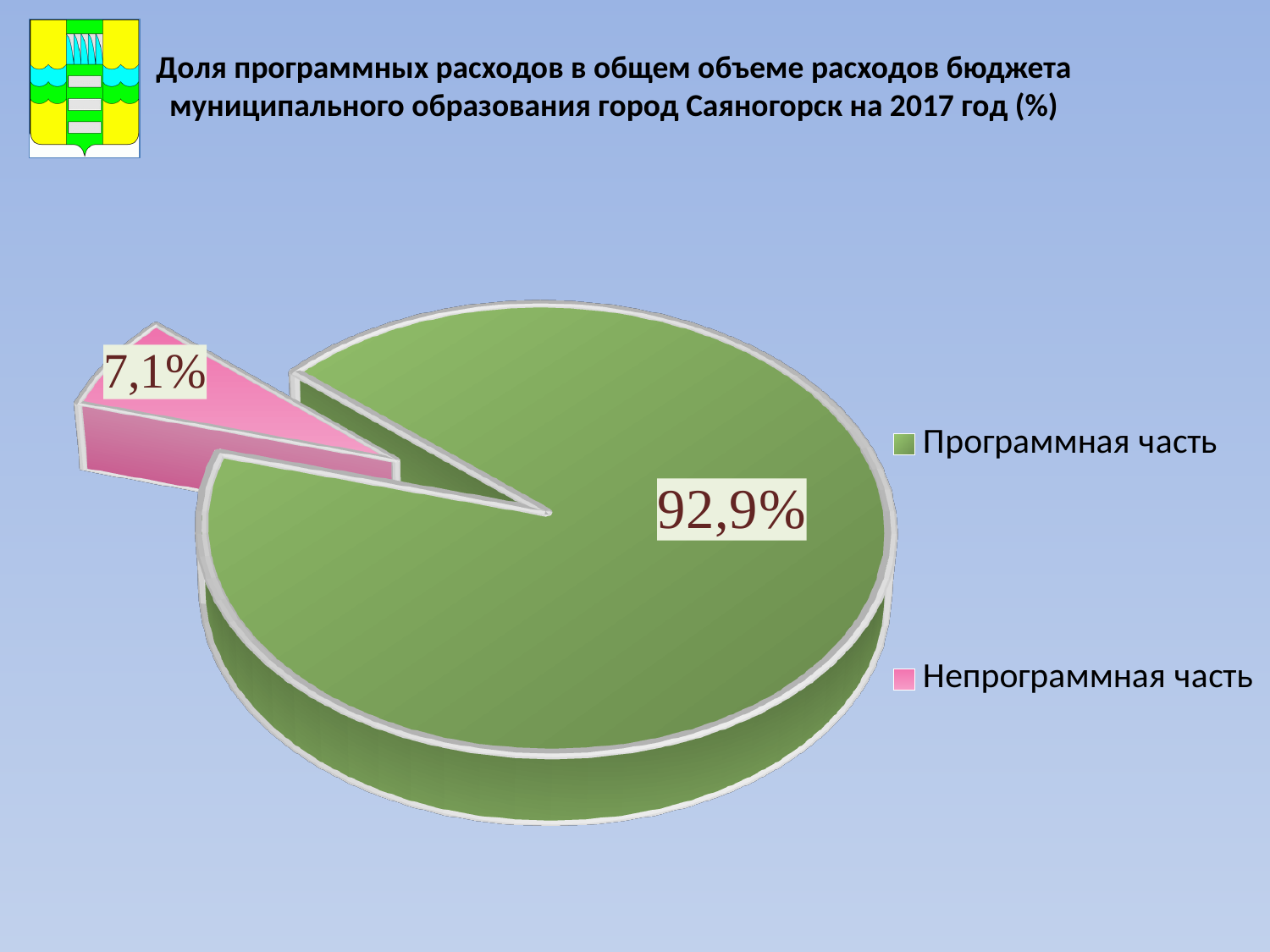
How many slices does the pie chart have? 2 What kind of chart is shown on the slide? Pie chart What share of the pie does Программная часть have? 92,9% Which slice of the pie is the largest? Программная часть Which is larger, Программная часть or Непрограммная часть? Программная часть How many entries does the legend list? 2 What colour is the Непрограммная часть slice? Pink What share of the pie does Непрограммная часть have? 7,1% Which slice of the pie is the smallest? Непрограммная часть What is the difference between the shares of Программная часть and Непрограммная часть? 85,8% What colour is the Программная часть slice? Green